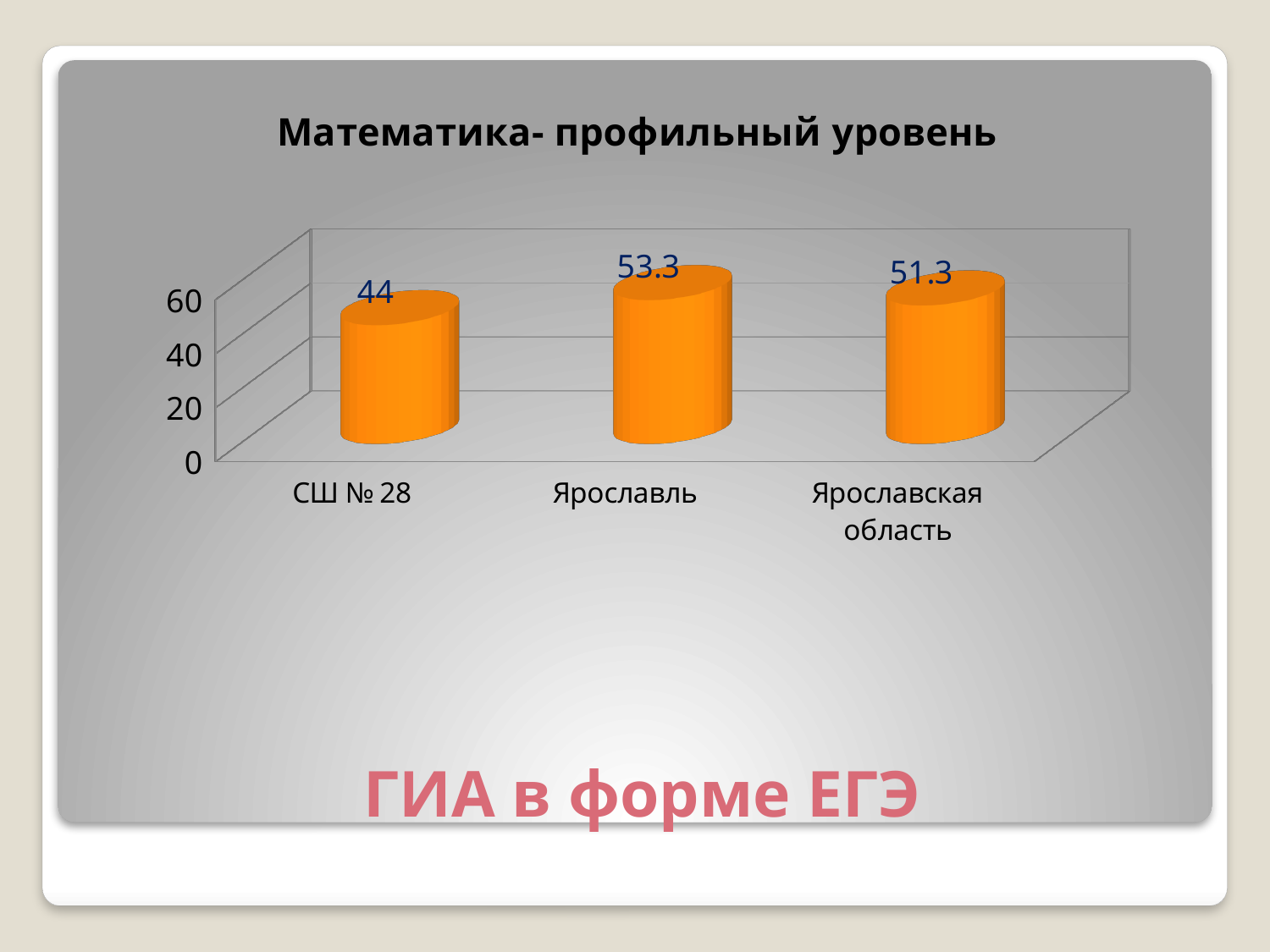
What is the difference between the values for Ярославль and Ярославская область? 2 What is the title of the chart? Математика- профильный уровень Which category has the lowest value? СШ № 28 Which category has the highest value? Ярославль What is the value for СШ № 28? 44 What is the value for Ярославская область? 51.3 What is the difference between the values for Ярославль and СШ № 28? 9.3 What is the value for Ярославль? 53.3 Is the value for СШ № 28 greater or less than 60? less Which is larger, the value for Ярославская область or the value for СШ № 28? Ярославская область How many categories are shown in the chart? 3 What kind of chart is shown on the slide? bar chart